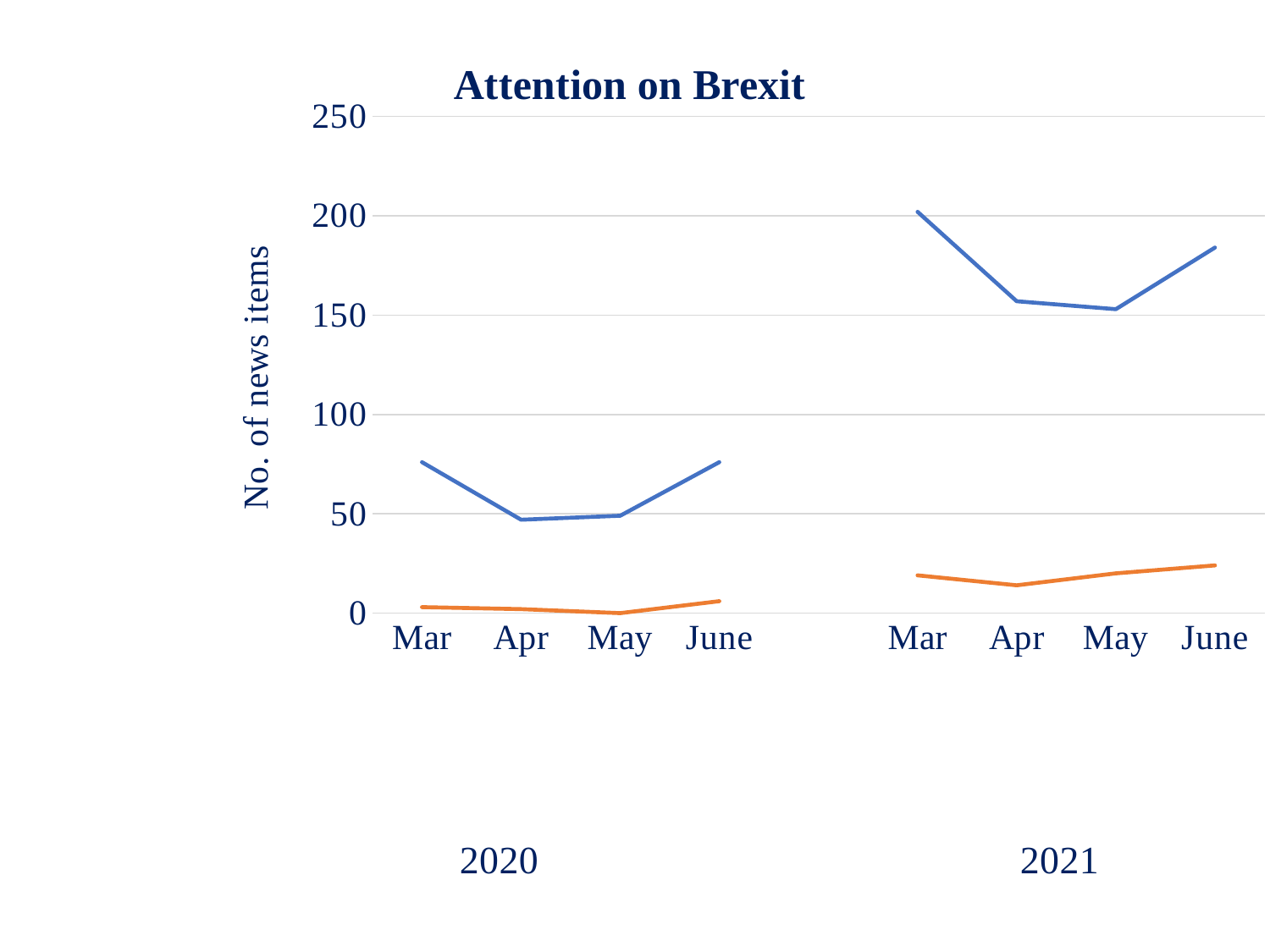
How many month points are shown along the x axis in total? 8 How many lines are plotted on the chart? 2 Is the value of the orange line for June 2021 greater or less than 50? less Is the value of the blue line for Mar 2021 greater or less than 150? greater At which month and year does the blue line reach its highest value? Mar 2021 Is the value of the blue line for Mar 2020 greater or less than 100? less What is the label on the vertical axis of the chart? No. of news items Does the blue line rise or fall from Mar to Apr in 2020? fall What is the title of the chart? Attention on Brexit Which is larger for the blue line: the value for Mar 2020 or the value for Mar 2021? Mar 2021 What kind of chart is shown on the slide? line chart